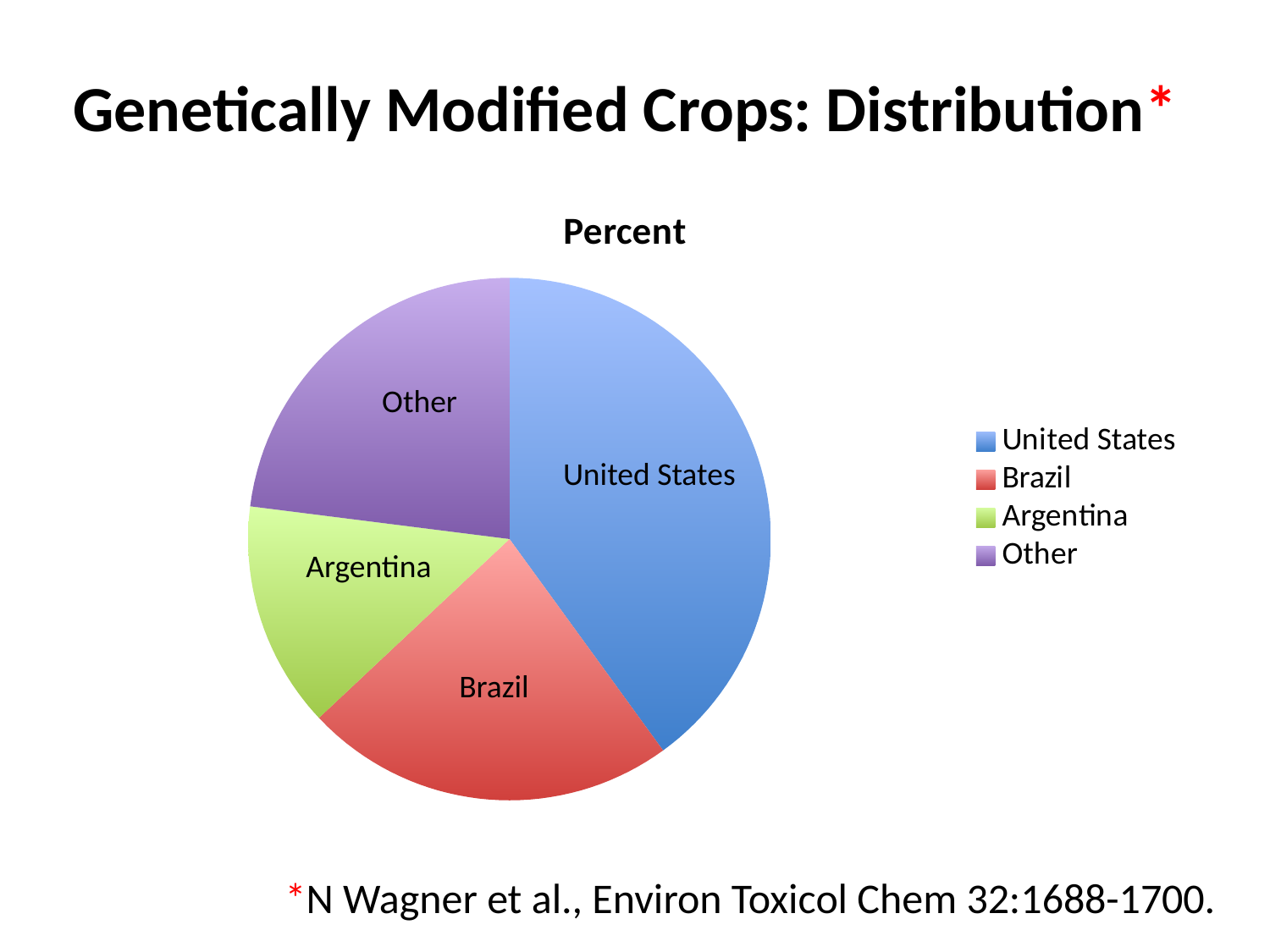
Which slice is larger, United States or Brazil? United States Which category has the largest slice of the pie? United States How many entries does the legend list? 4 What colour is the Argentina slice? Green What kind of chart is shown on the slide? Pie chart Which category has the smallest slice of the pie? Argentina How many slices does the pie chart have? 4 Which slice is larger, Argentina or United States? United States What is the title of the chart? Percent Which slice is larger, Brazil or Argentina? Brazil